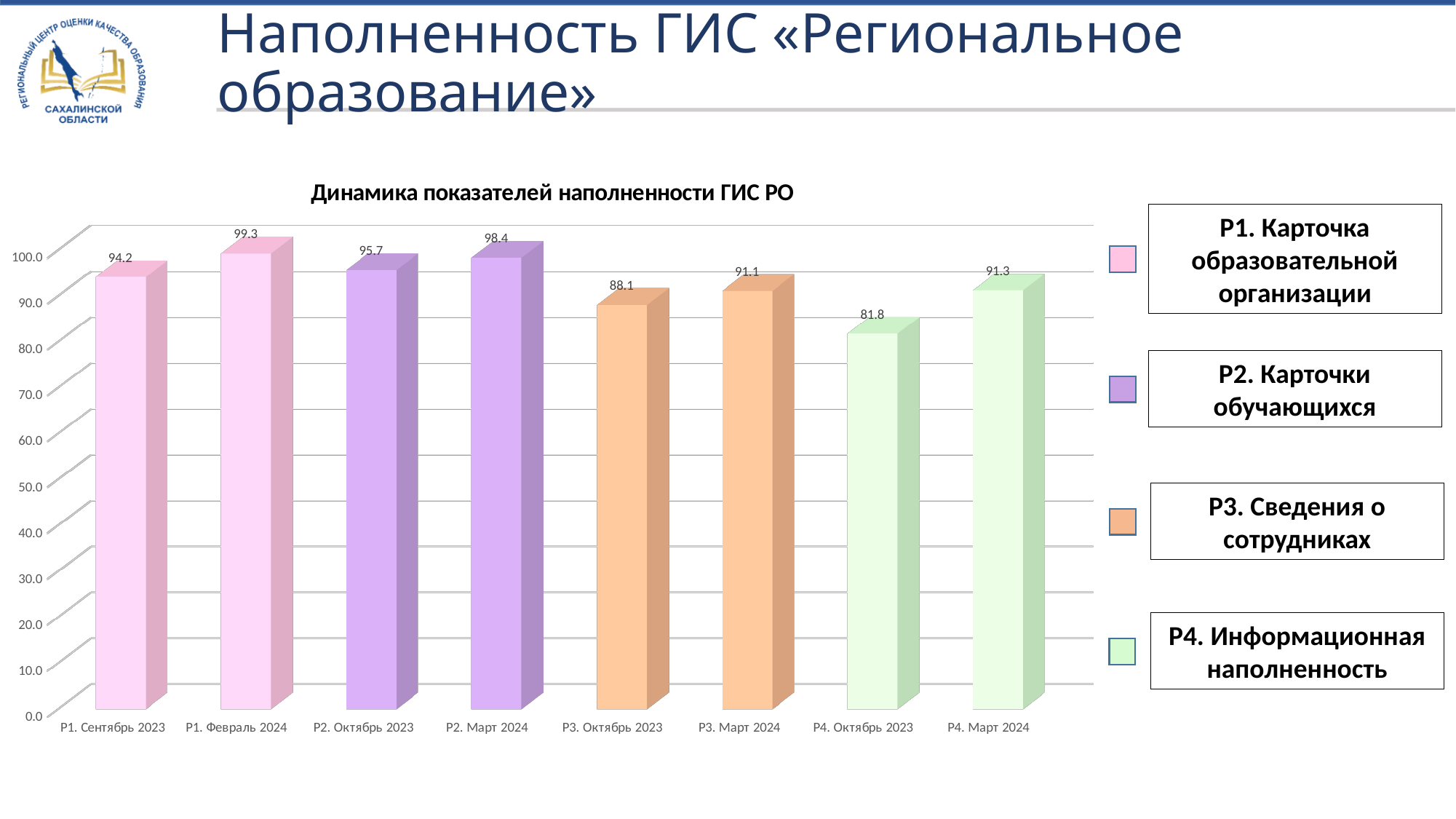
Which category has the highest value? Р1. Февраль 2024 What is the difference between the values for Р2. Март 2024 and Р2. Октябрь 2023? 2.7 What is the title of the chart? Динамика показателей наполненности ГИС РО What is the value for Р4. Октябрь 2023? 81.8 What is the value for Р1. Февраль 2024? 99.3 Which is larger, the value for Р3. Октябрь 2023 or the value for Р3. Март 2024? Р3. Март 2024 Is the value for Р3. Октябрь 2023 greater or less than 90.0? less What is the value for Р3. Март 2024? 91.1 Which category has the lowest value? Р4. Октябрь 2023 How many bars are plotted in the chart? 8 What is the difference between the values for Р4. Март 2024 and Р4. Октябрь 2023? 9.5 What kind of chart is shown on the slide? bar chart